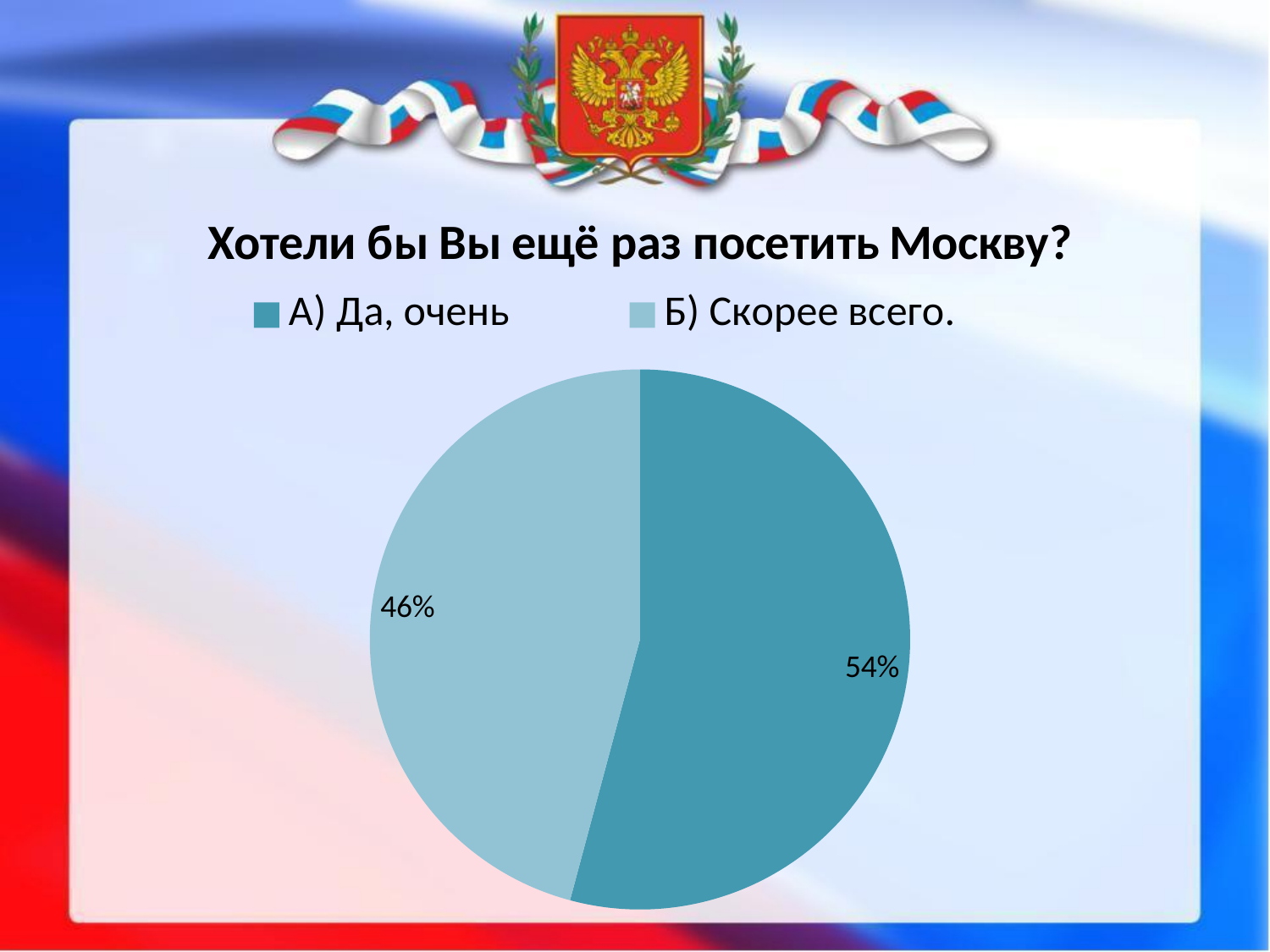
Which slice of the pie is the largest? А) Да, очень What share of the pie is labelled "Б) Скорее всего."? 46% What is the total of the two slices shown in the pie chart? 100% What is the difference in percentage points between the "А) Да, очень" slice and the "Б) Скорее всего." slice? 8% What kind of chart is shown on the slide? pie chart How many entries does the legend list? 2 How many slices does the pie chart have? 2 What share of the pie is labelled "А) Да, очень"? 54% Is the share for "Б) Скорее всего." greater or less than 50%? less Which slice of the pie is the smallest? Б) Скорее всего. What is the title of the chart? Хотели бы Вы ещё раз посетить Москву? Which is larger: the share for "А) Да, очень" or the share for "Б) Скорее всего."? А) Да, очень